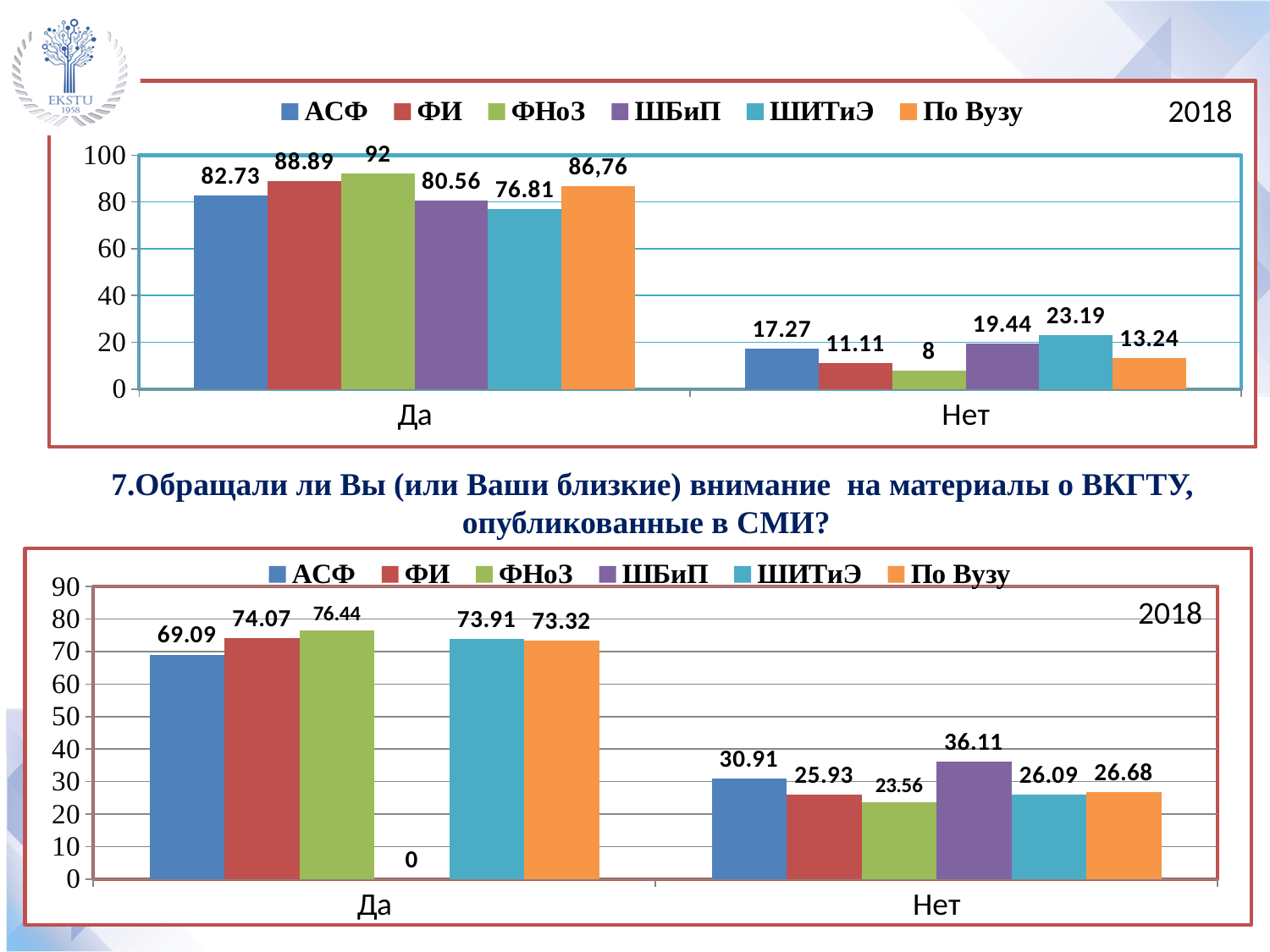
In the bottom chart, what is the difference between АСФ and ФНоЗ in the Нет category? 7.35 How many series does the legend of the top chart list? 6 In the bottom chart, what is the value for ШБиП in the Нет category? 36.11 In the bottom chart, which series has the highest value in the Нет category? ШБиП What type of chart is the bottom chart? Bar chart In the bottom chart, which is larger in the Да category, АСФ or ФИ? ФИ In the top chart, which series has the lowest value in the Нет category? ФНоЗ In the top chart, what is the difference between АСФ and ФИ in the Да category? 6.16 In the top chart, what is the value for ФНоЗ in the Да category? 92 In the top chart, which series has the highest value in the Да category? ФНоЗ In the top chart, what is the value for ШИТиЭ in the Нет category? 23.19 In the bottom chart, what is the value for ШБиП in the Да category? 0